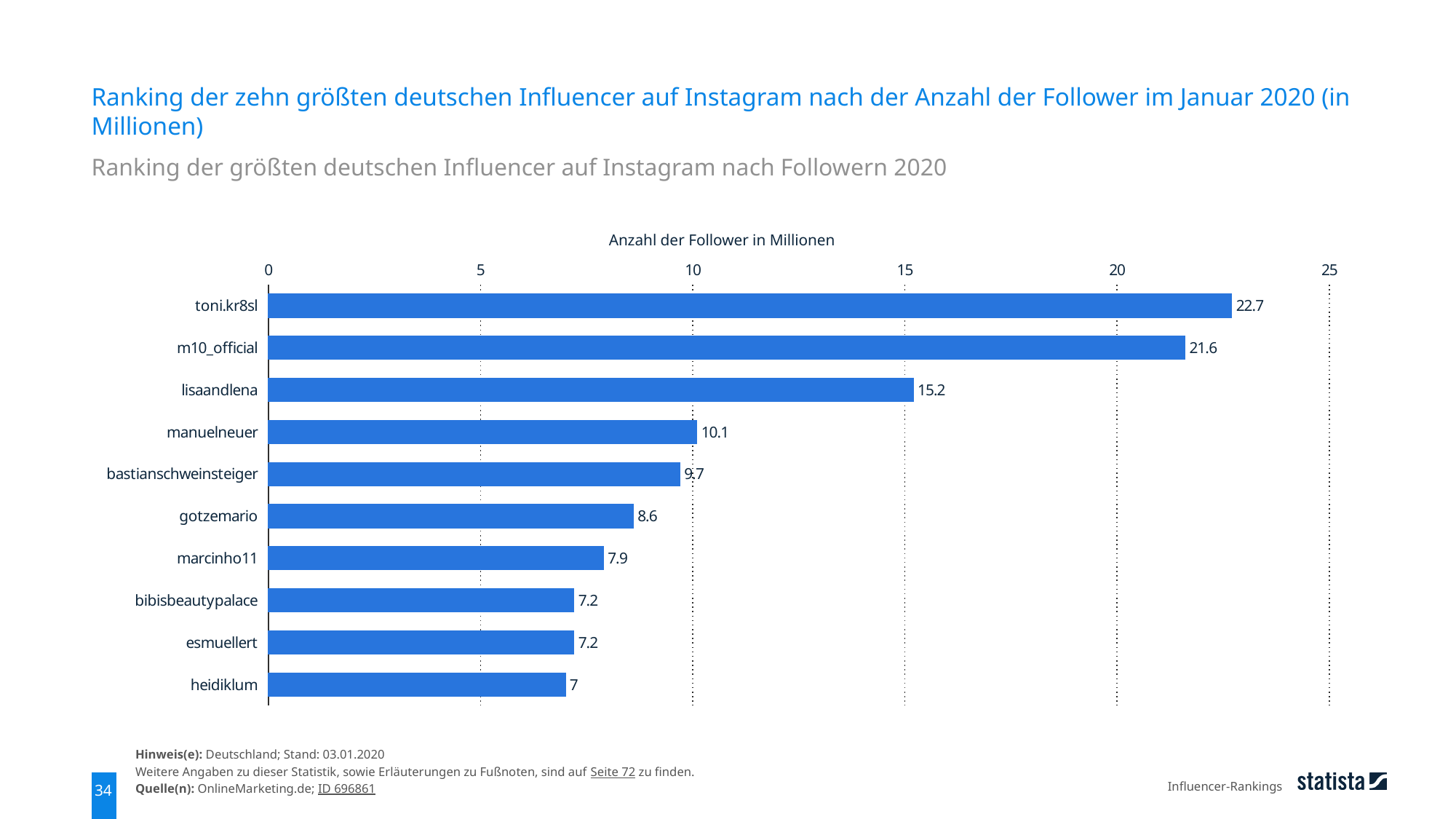
How many followers in millions does toni.kr8sl have? 22.7 How many influencers are shown in the chart? 10 What is the difference in followers (in millions) between toni.kr8sl and m10_official? 1.1 Is the value for marcinho11 greater or less than 10? less What is the difference in followers (in millions) between manuelneuer and bastianschweinsteiger? 0.4 Which influencer has the highest number of followers? toni.kr8sl What is the axis title shown above the chart? Anzahl der Follower in Millionen What is the value shown for gotzemario? 8.6 Who has more followers, lisaandlena or manuelneuer? lisaandlena What kind of chart is shown on the slide? bar chart Which influencer has the lowest number of followers? heidiklum What is the value shown for lisaandlena? 15.2